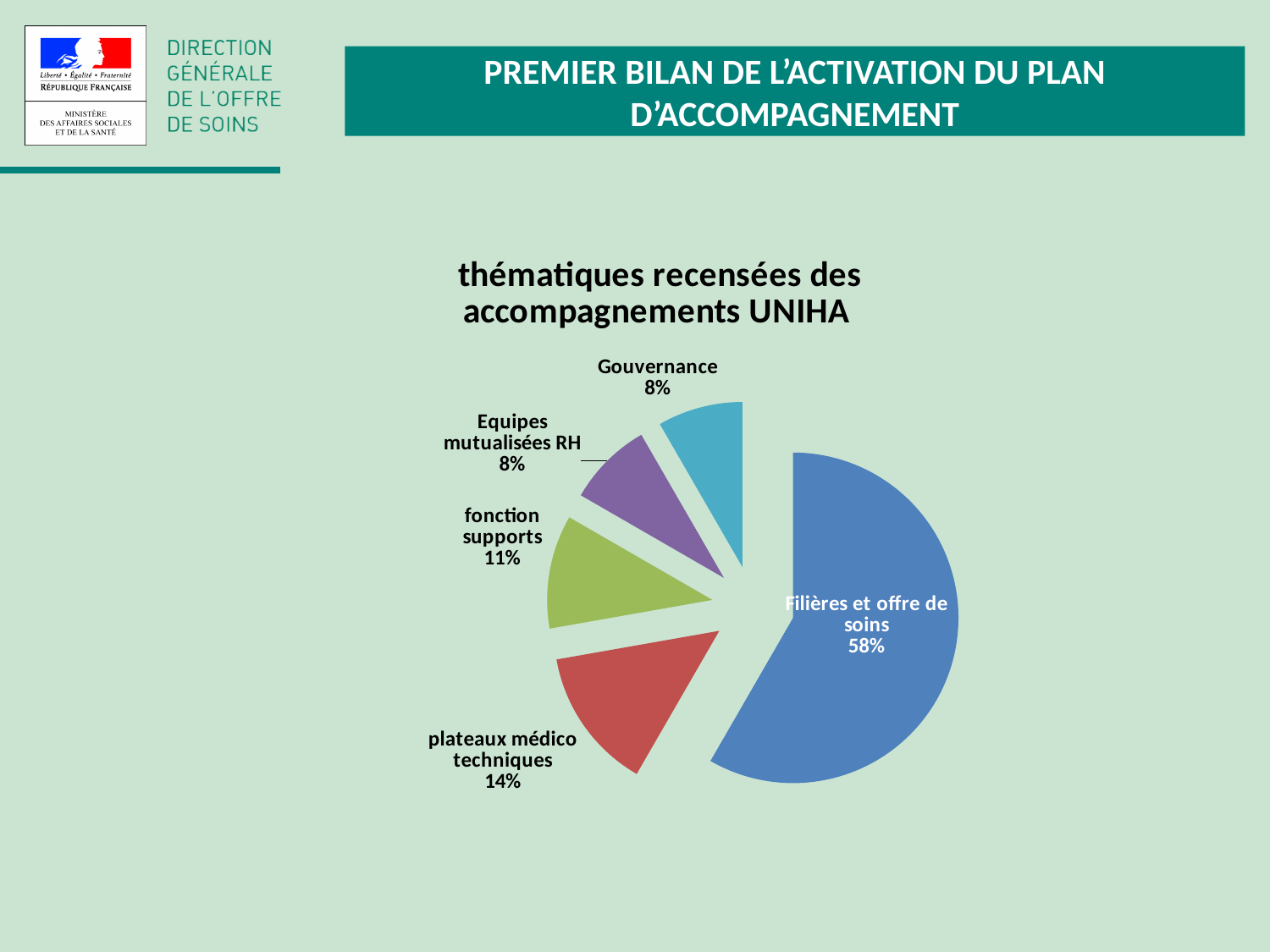
What is the difference in percentage points between "Filières et offre de soins" and "plateaux médico techniques"? 44 What percentage is shown for "Equipes mutualisées RH"? 8% What share of the pie does "Filières et offre de soins" represent? 58% What percentage is shown for "fonction supports"? 11% Which is larger, the share for "fonction supports" or the share for "Gouvernance"? fonction supports What percentage is shown for "Gouvernance"? 8% What percentage is shown for "plateaux médico techniques"? 14% What type of chart is shown on the slide? pie chart How many slices does the pie chart have? 5 Which category has the largest share of the pie? Filières et offre de soins What is the title of the chart? thématiques recensées des accompagnements UNIHA What colour is the "Filières et offre de soins" slice? blue